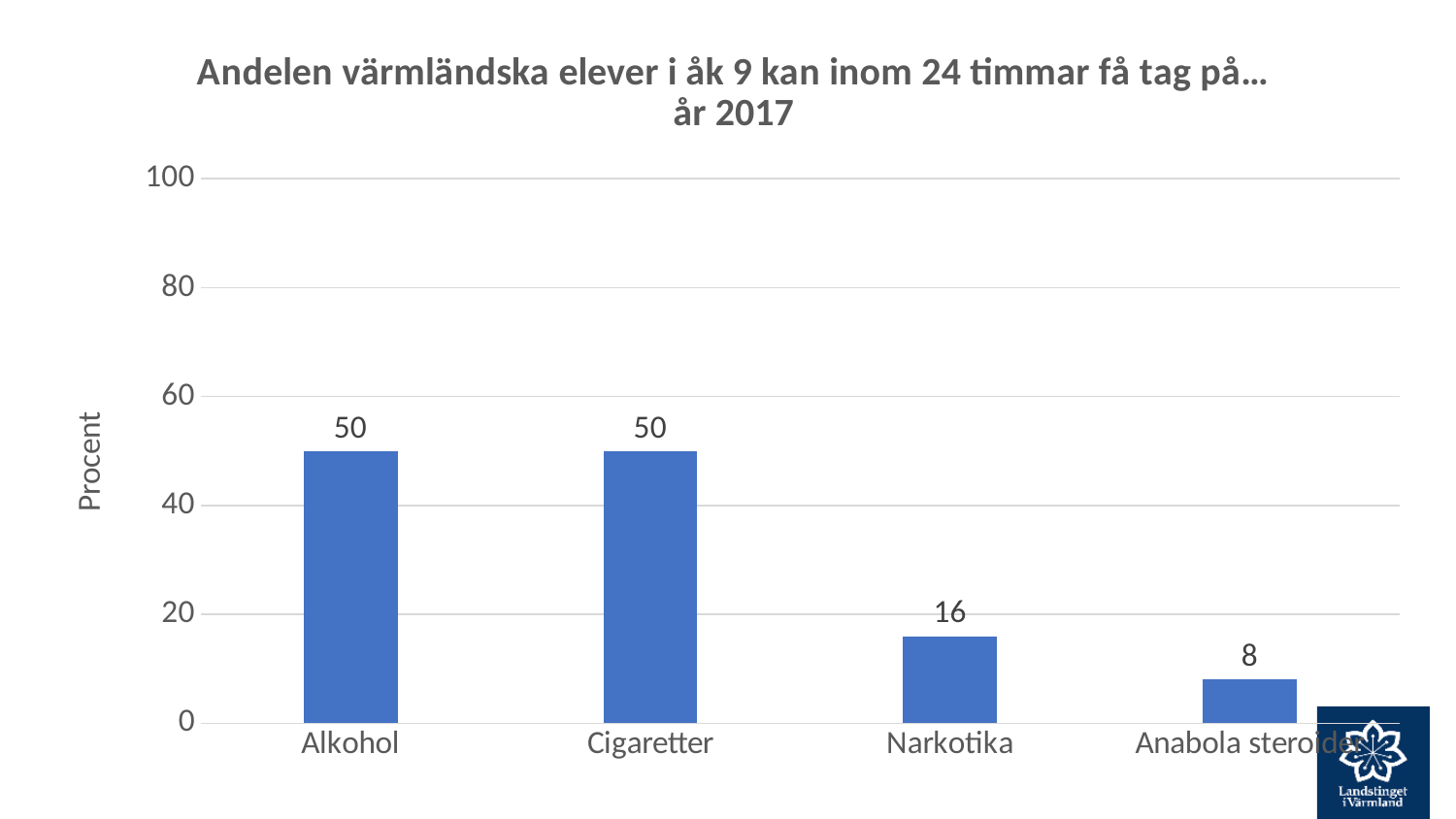
What is the value for Cigaretter? 50 Is the value for Cigaretter greater or less than 40? greater Which is larger, the value for Narkotika or the value for Anabola steroider? Narkotika Which category has the lowest value? Anabola steroider What is the difference between the values for Alkohol and Narkotika? 34 What kind of chart is shown on the slide? bar chart What is the value for Anabola steroider? 8 What is the value for Narkotika? 16 How many categories are shown on the x axis? 4 What is the value for Alkohol? 50 What is the label of the vertical axis? Procent What is the difference between the values for Narkotika and Anabola steroider? 8